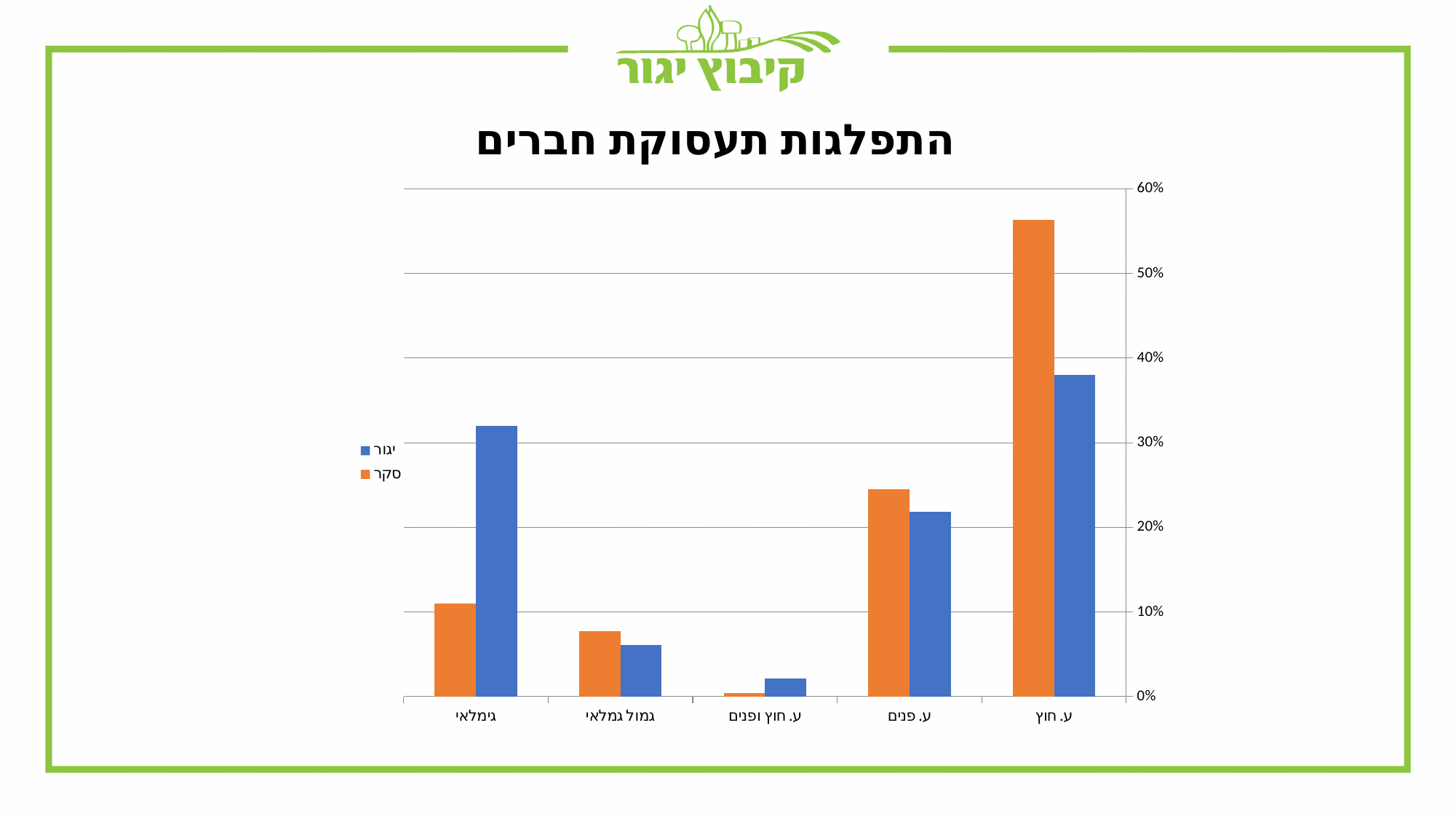
Which category has the highest value for the יגור series? ע. חוץ For the category ע. חוץ, which series has the larger value, יגור or סקר? סקר Is the יגור value for גמול גמלאי greater or less than 10%? less How many categories are shown on the x axis? 5 For the category גימלאי, which series has the larger value, יגור or סקר? יגור How many series does the legend list? 2 Which category has the lowest value for the יגור series? ע. חוץ ופנים Which colour represents the יגור series in the chart? blue Is the סקר value for ע. חוץ greater or less than 50%? greater What kind of chart is shown on the slide? bar chart Which category has the highest value for the סקר series? ע. חוץ Which category has the lowest value for the סקר series? ע. חוץ ופנים